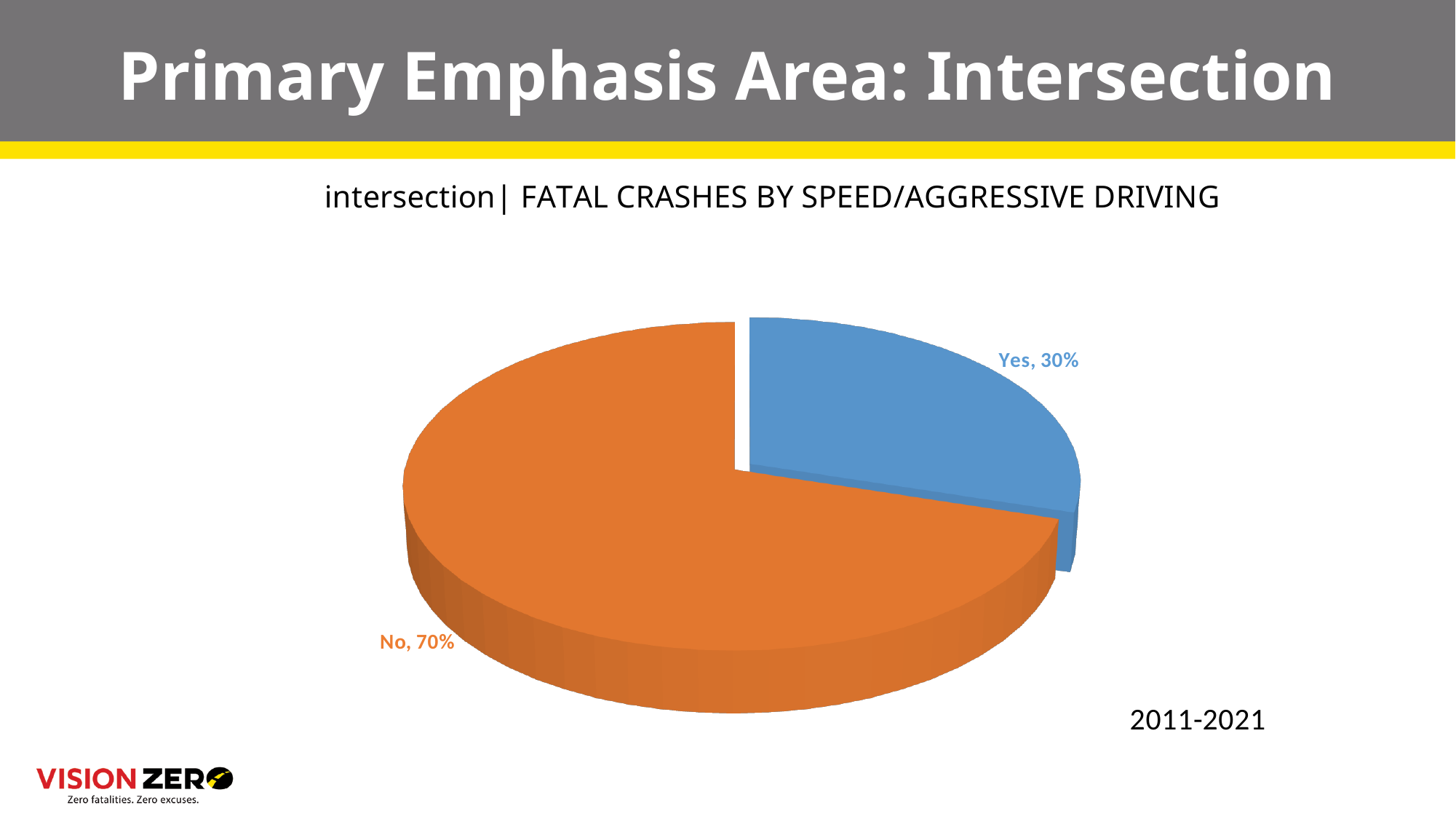
What is the title of the chart? intersection| FATAL CRASHES BY SPEED/AGGRESSIVE DRIVING Which slice of the pie is the smallest? Yes How many slices does the pie chart have? 2 What kind of chart is shown on the slide? Pie chart What is the difference in percentage points between the No and Yes slices? 40 What share of intersection fatal crashes did not involve speed/aggressive driving (No)? 70% What colour is the Yes slice of the pie? Blue Which is larger, the Yes slice or the No slice? No What time period does the chart cover? 2011-2021 Which slice of the pie is the largest? No What share of intersection fatal crashes involved speed/aggressive driving (Yes)? 30%